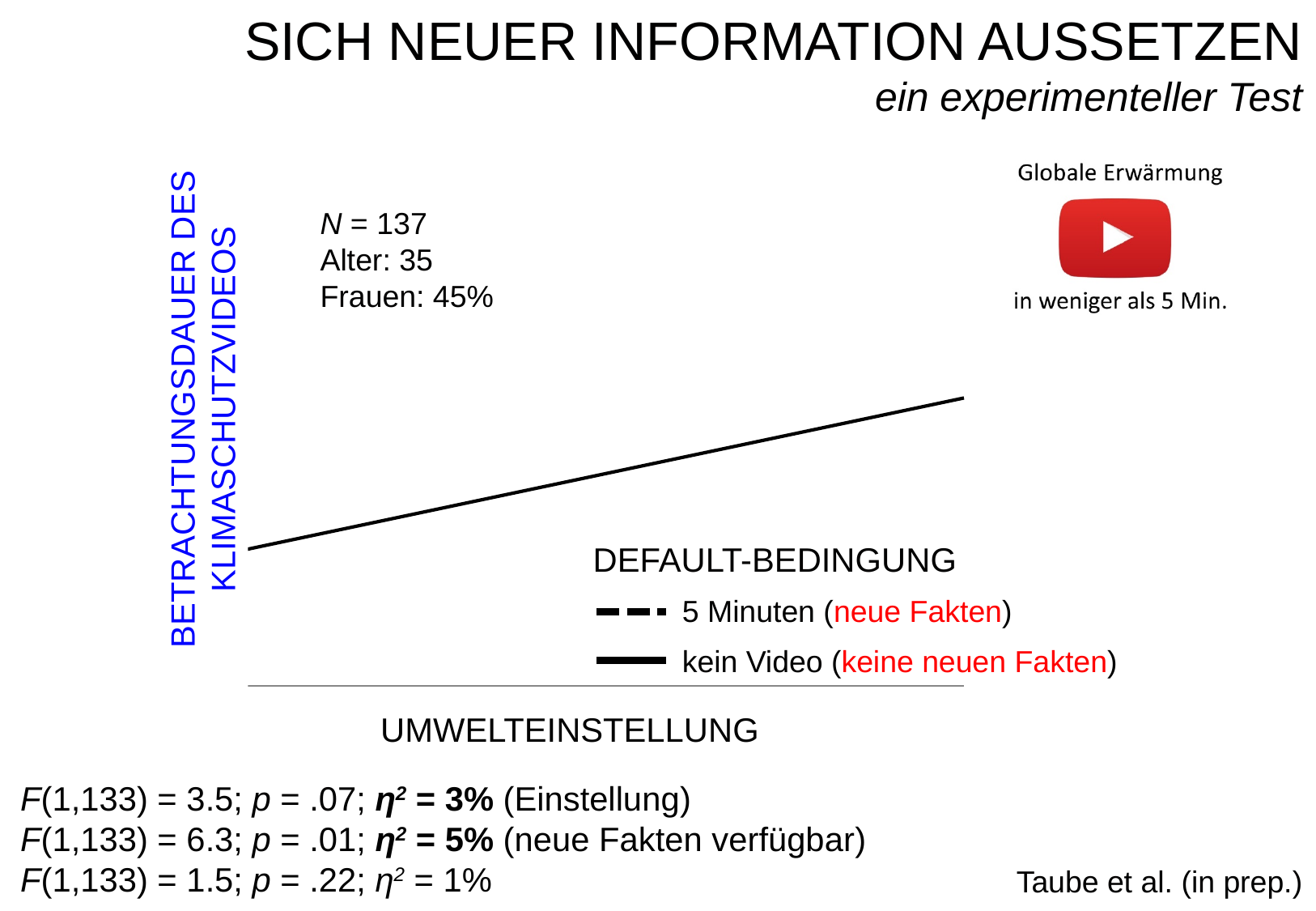
What is the label of the x axis of the chart? UMWELTEINSTELLUNG Does the solid line for 'kein Video (keine neuen Fakten)' rise or fall as Umwelteinstellung increases along the x axis? rise Which legend entry is drawn with a solid line? kein Video (keine neuen Fakten) How many series does the legend under 'DEFAULT-BEDINGUNG' list? 2 How many lines are actually plotted on the chart? 1 Which legend entry is drawn with a dashed line? 5 Minuten (neue Fakten) What kind of chart is shown on the slide? line chart